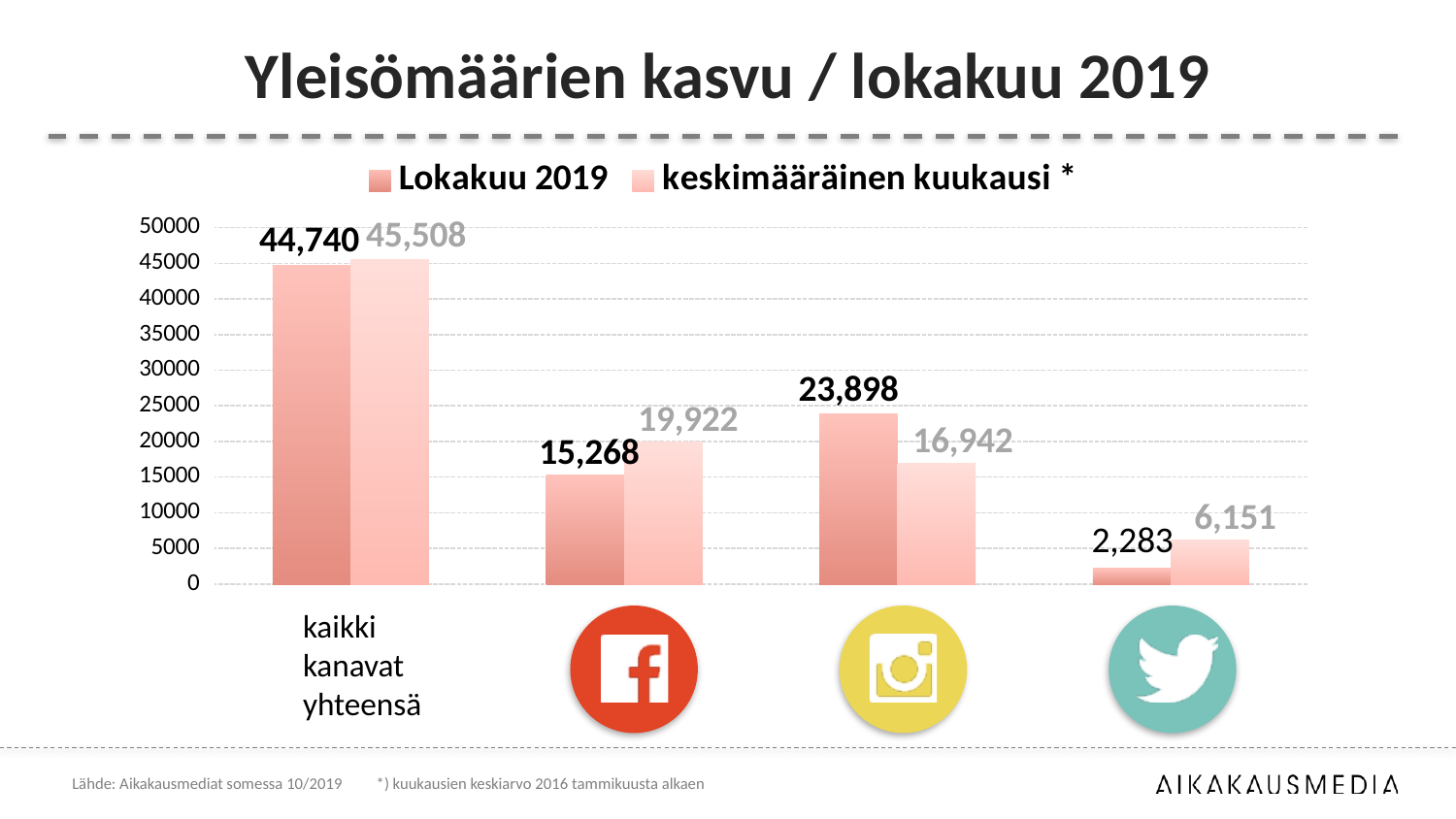
What is the keskimääräinen kuukausi value for the Facebook category? 19,922 Which category has the lowest Lokakuu 2019 value? Twitter What kind of chart is shown on the slide? bar chart What is the difference between the Lokakuu 2019 and keskimääräinen kuukausi values for the Instagram category? 6,956 Which category has the highest keskimääräinen kuukausi value? kaikki kanavat yhteensä What is the keskimääräinen kuukausi value for the Twitter category? 6,151 How many series does the legend list? 2 How many categories are shown on the x axis? 4 For the Facebook category, which is larger: the Lokakuu 2019 value or the keskimääräinen kuukausi value? keskimääräinen kuukausi What is the Lokakuu 2019 value for kaikki kanavat yhteensä? 44,740 What is the Lokakuu 2019 value for the Instagram category? 23,898 What is the title of the chart slide? Yleisömäärien kasvu / lokakuu 2019